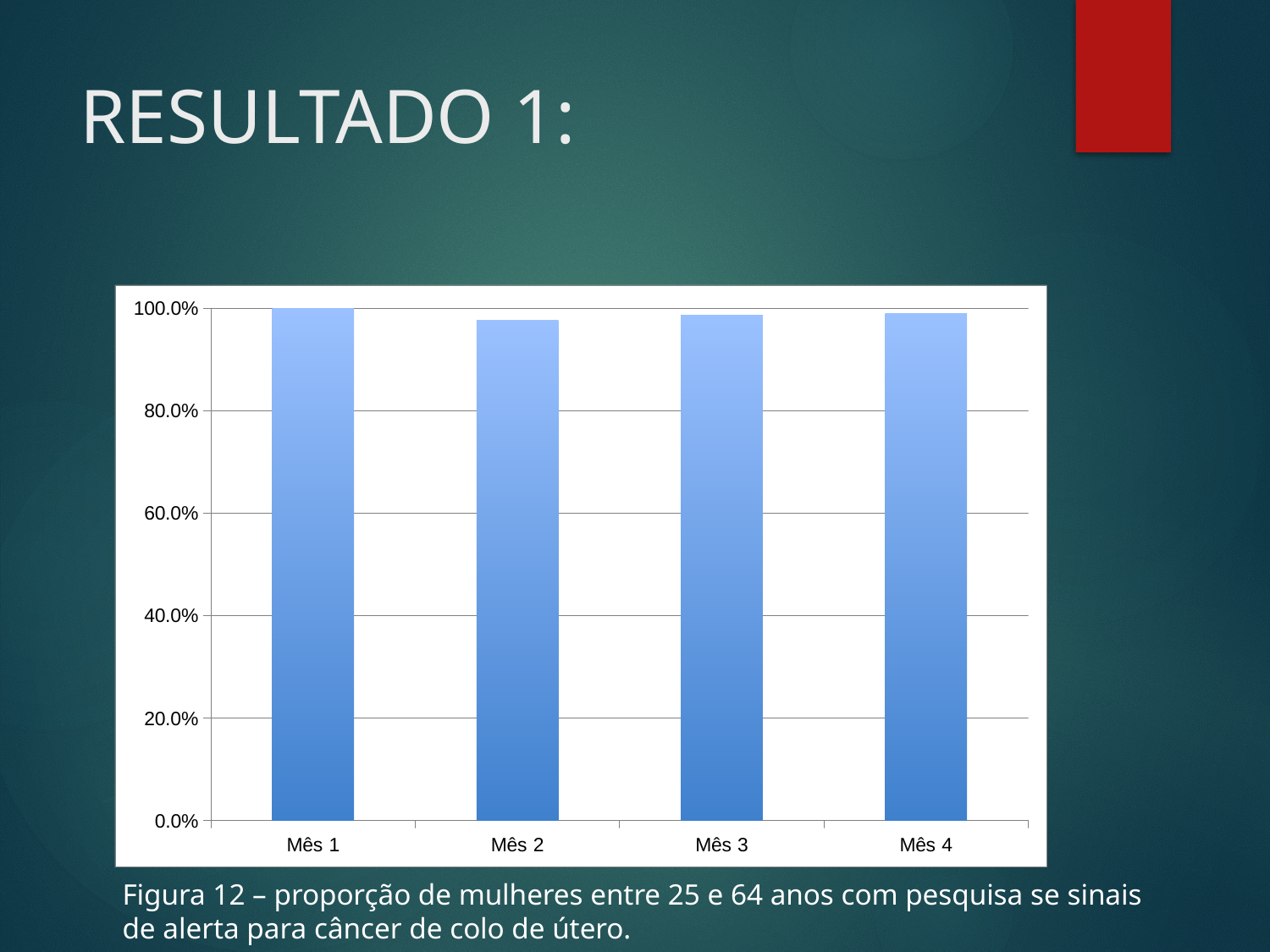
Is the value for Mês 4 greater or less than 80.0%? greater Is the value for Mês 2 greater or less than 80.0%? greater Which month has the lowest value on the chart? Mês 2 How many categories (months) are plotted on the chart? 4 Which month has the highest value on the chart? Mês 1 What kind of chart is shown on the slide? bar chart Is the value for Mês 3 greater or less than 60.0%? greater What is the value for Mês 1? 100.0% What is the highest value shown on the vertical axis? 100.0% What is the figure number given in the caption below the chart? Figura 12 Which is larger, the value for Mês 1 or the value for Mês 2? Mês 1